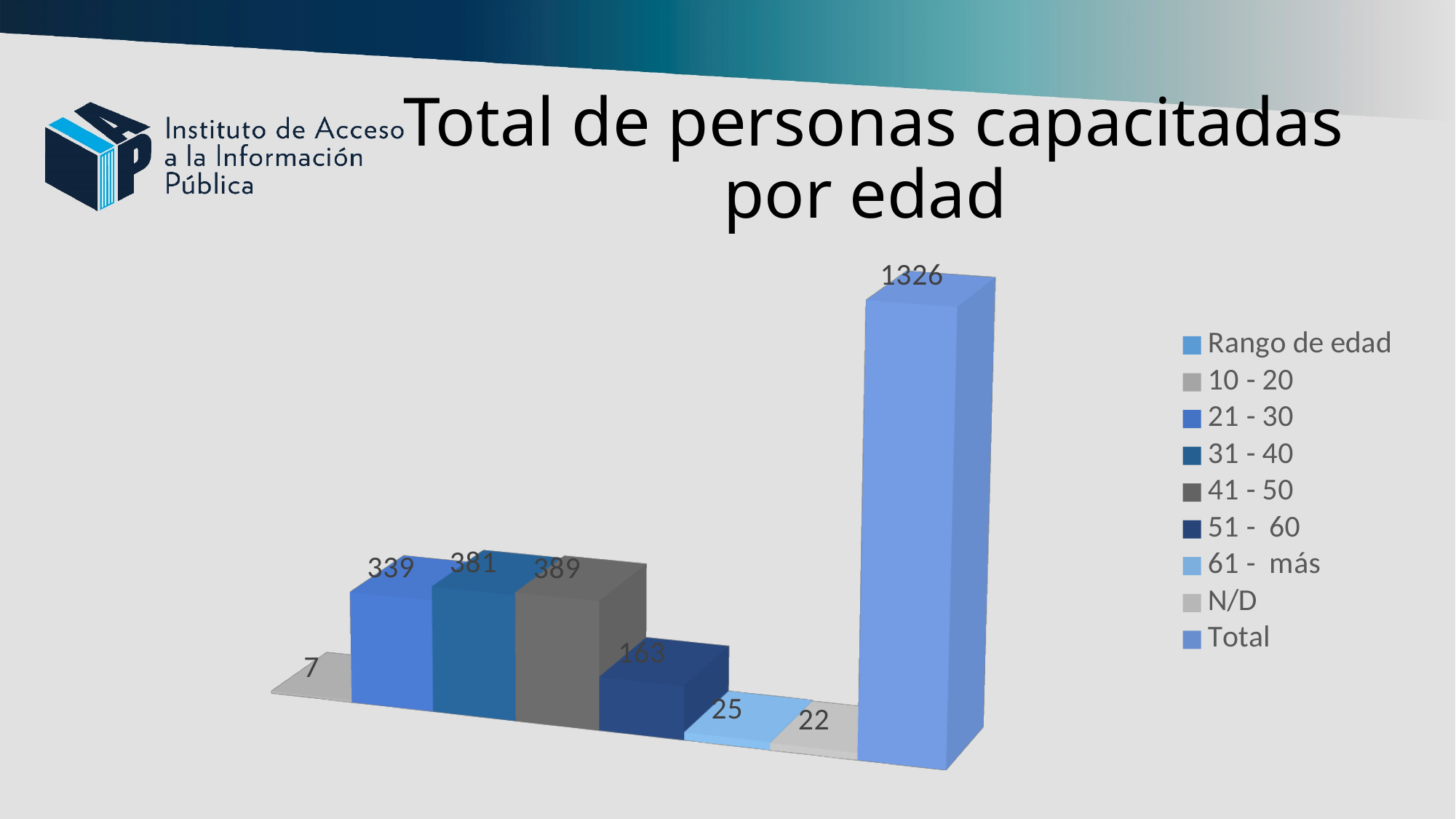
What is the value shown for Total? 1326 What is the value for the 41 - 50 age range? 389 Which category has the lowest value? 10 - 20 What is the value for the 51 - 60 age range? 163 Which is larger, the value for 61 - más or the value for N/D? 61 - más What is the difference between the values for 41 - 50 and 31 - 40? 8 What is the value for the 10 - 20 age range? 7 What is the title of the chart on the slide? Total de personas capacitadas por edad How many entries does the legend list? 9 What is the value for the 21 - 30 age range? 339 Which age range (excluding Total) has the highest value? 41 - 50 What kind of chart is shown on the slide? Bar chart